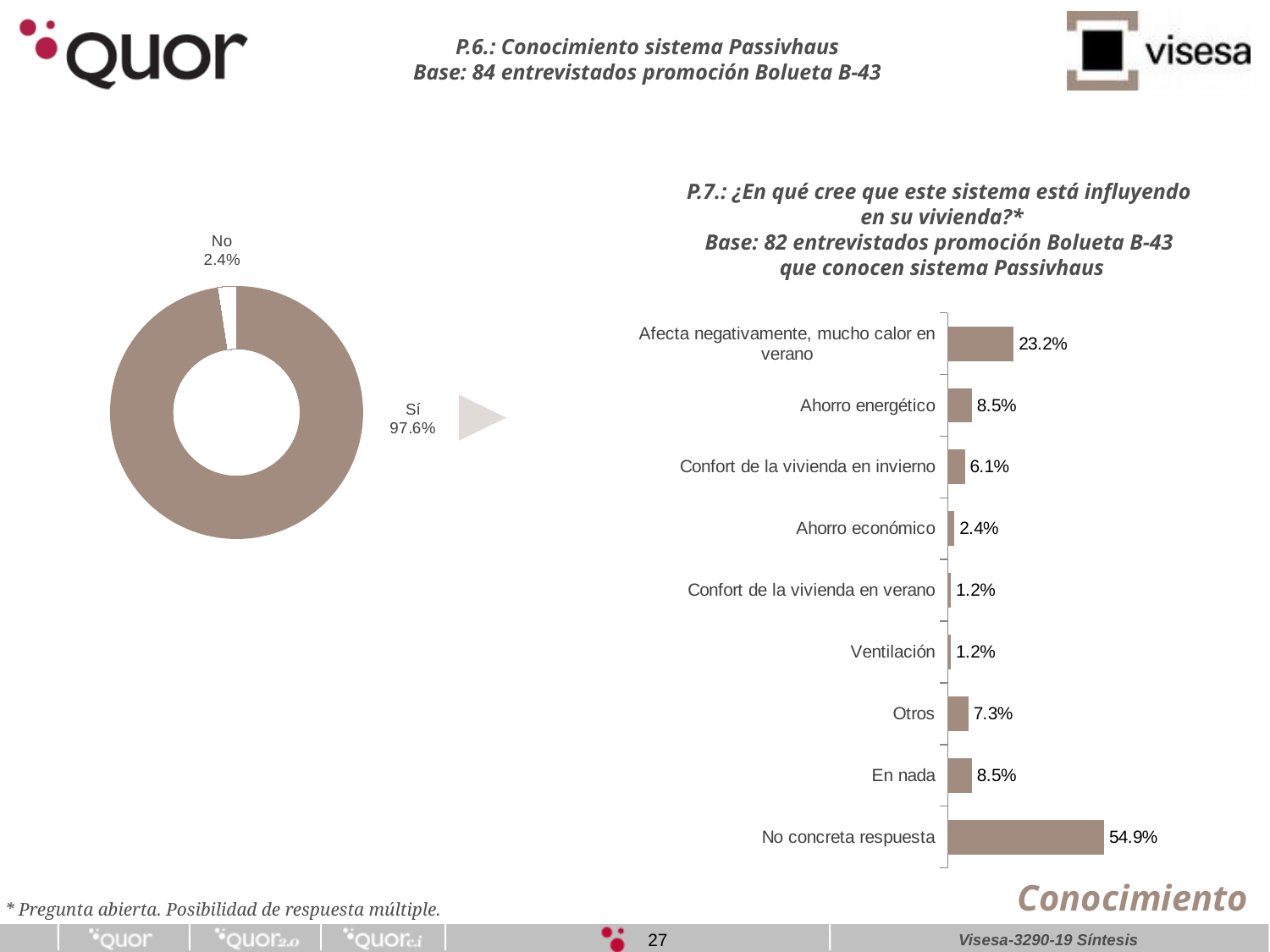
In the left-hand donut chart (P.6), what percentage of respondents answered "Sí"? 97.6% In the right-hand bar chart (P.7), which category has the highest value? No concreta respuesta What kind of chart is the right-hand chart (P.7)? Bar chart In the right-hand bar chart (P.7), what is the difference between "No concreta respuesta" and "Afecta negativamente, mucho calor en verano"? 31.7% What is the base (number of interviewees) stated in the title of the right-hand chart (P.7)? 82 entrevistados How many categories are shown in the right-hand bar chart (P.7)? 9 In the right-hand bar chart (P.7), what is the value for "Ahorro energético"? 8.5% In the left-hand donut chart (P.6), what percentage of respondents answered "No"? 2.4% In the right-hand bar chart (P.7), which is larger: "Otros" or "Confort de la vivienda en invierno"? Otros In the right-hand bar chart (P.7), what is the value for "Afecta negativamente, mucho calor en verano"? 23.2% What kind of chart is the left-hand chart (P.6)? Pie (donut) chart In the right-hand bar chart (P.7), what is the value for "Ahorro económico"? 2.4%